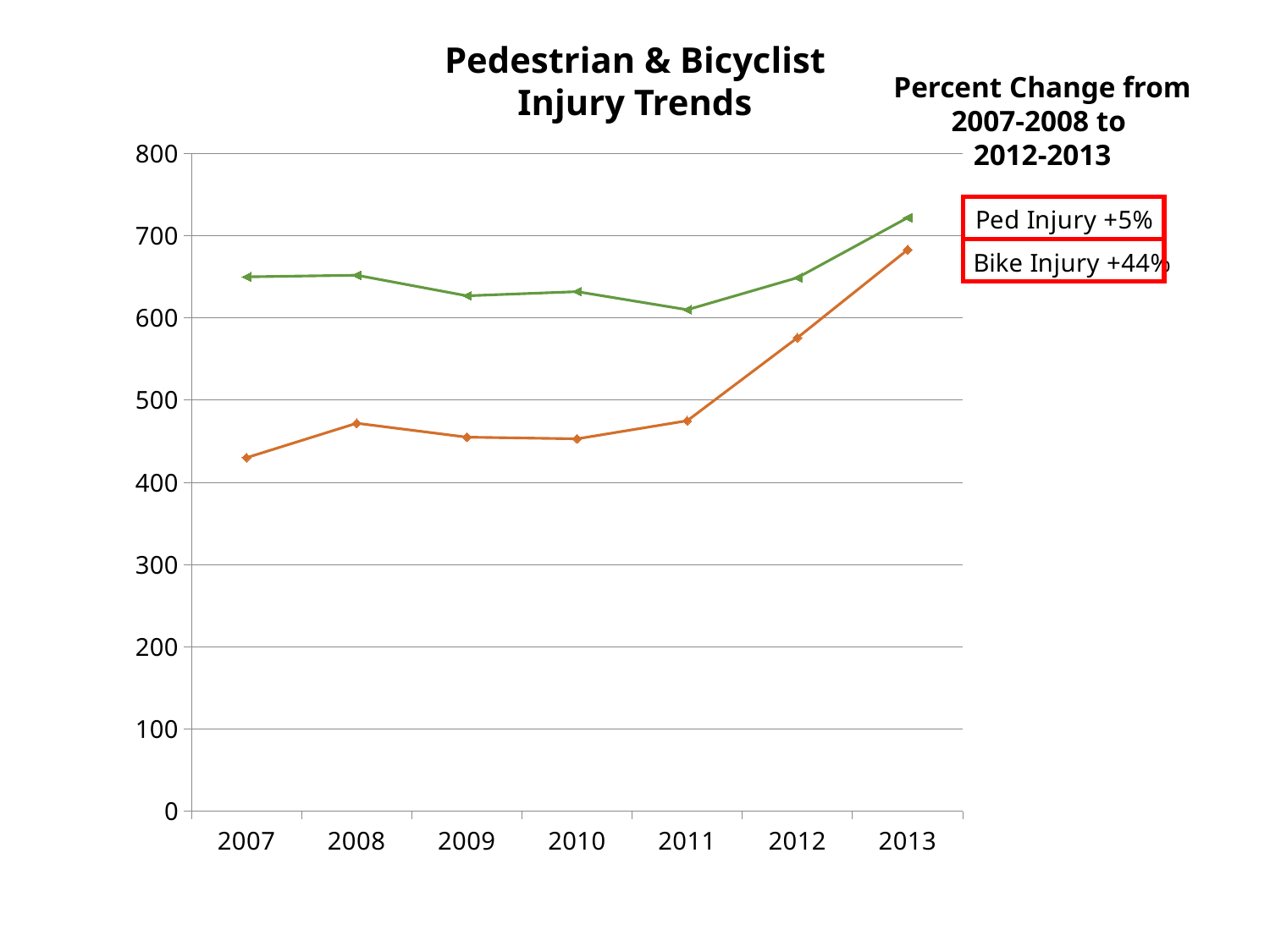
How many years are plotted along the x axis of the Pedestrian & Bicyclist Injury Trends chart? 7 What kind of chart is shown on the slide? line chart In 2013, which line has the higher value, the green line or the orange line? green line Does the orange line rise or fall between 2011 and 2013? rise In which year does the green line reach its highest value? 2013 Is the value of the orange line in 2007 greater or less than 500? less In which year does the orange line have its lowest value? 2007 Is the value of the green line in 2011 greater or less than 700? less What percent change from 2007-2008 to 2012-2013 is shown for Bike Injury? +44% Is the value of the orange line in 2012 greater or less than 500? greater What percent change from 2007-2008 to 2012-2013 is shown for Ped Injury? +5%